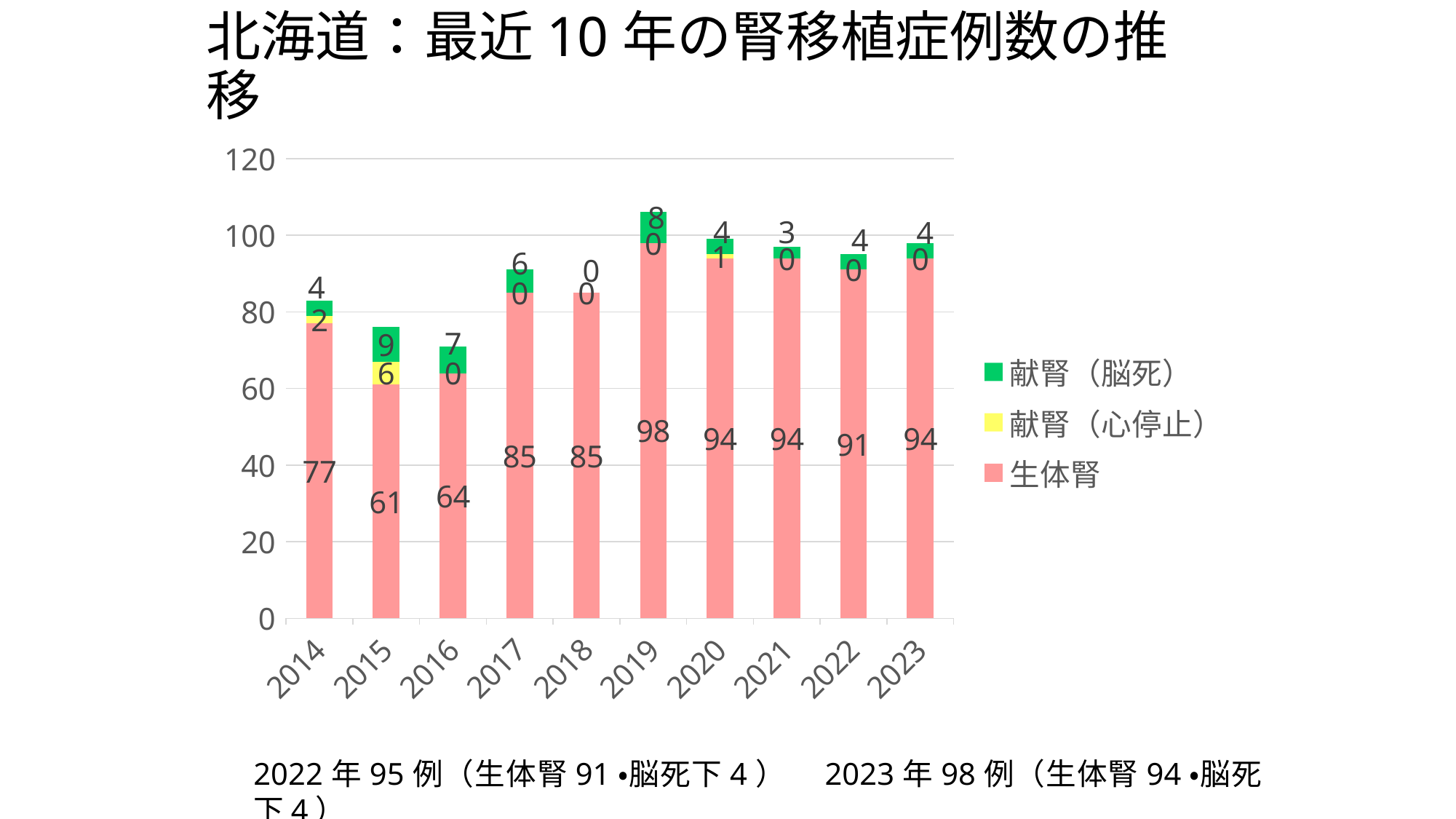
What is the total of the stacked bar for 2019? 106 How many series does the legend list? 3 What is the value of 献腎（心停止） for 2014? 2 What is the value of 献腎（脳死） for 2015? 9 How many years are shown on the x axis? 10 Which year has the highest value for 生体腎? 2019 Which is larger, the 献腎（脳死） value for 2016 or for 2017? 2016 Which year has the lowest value for 生体腎? 2015 What is the difference between the 生体腎 values for 2019 and 2015? 37 What is the value of 生体腎 for 2019? 98 What kind of chart is shown on the slide? Stacked bar chart What is the total of the stacked bar for 2015? 76